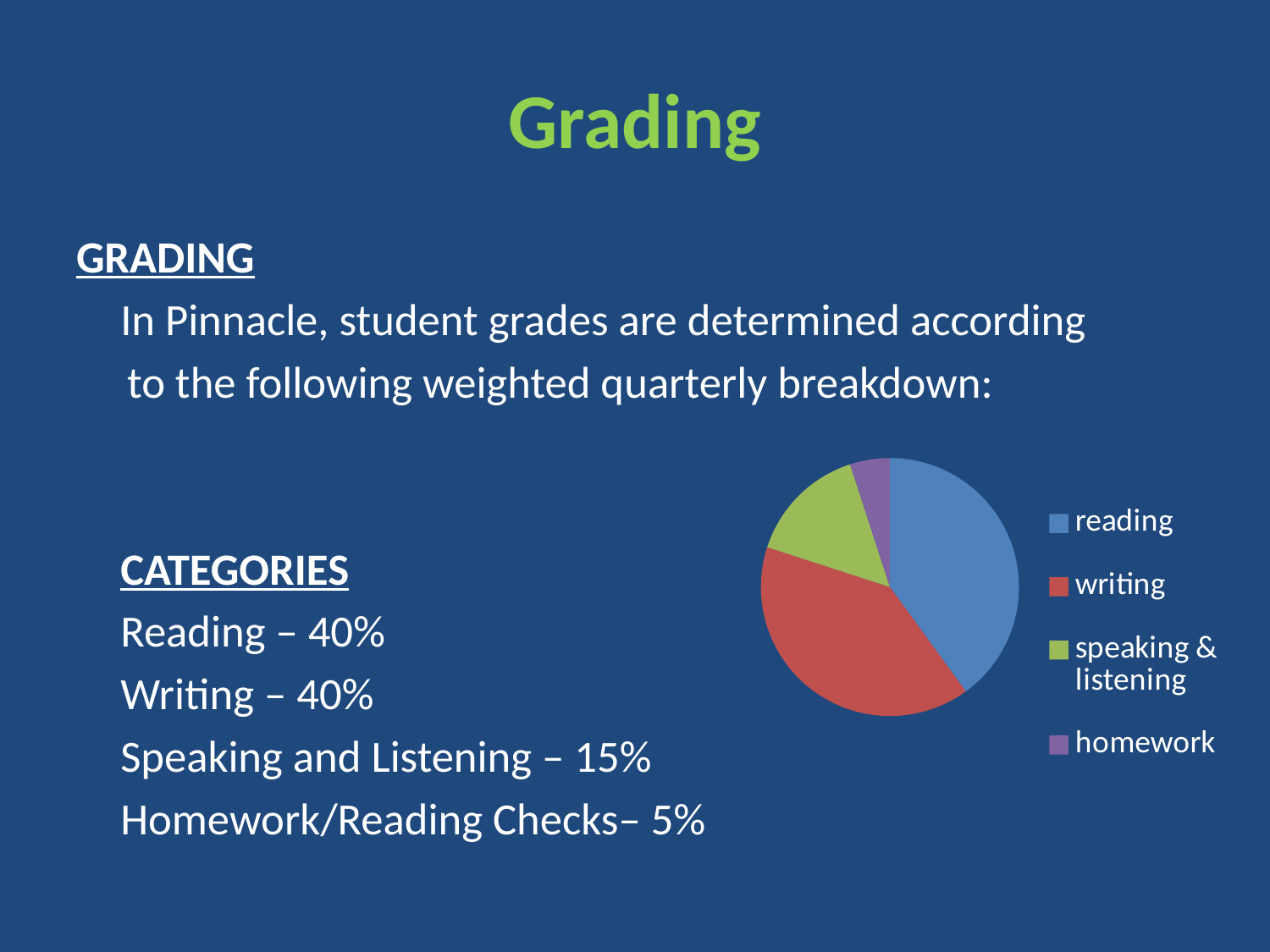
Which slice is larger in the pie chart, speaking & listening or homework? speaking & listening What kind of chart is shown on the slide? pie chart According to the slide, what share of the grade is Writing? 40% According to the slide, what share of the grade is Speaking and Listening? 15% Which legend entry is shown in green? speaking & listening Which colour represents writing in the pie chart? red How many slices does the pie chart have? 4 According to the slide, what share of the grade is Homework/Reading Checks? 5% How many entries does the pie chart's legend list? 4 What is the difference between the Reading share and the Speaking and Listening share? 25% Which category has the smallest slice in the pie chart? homework